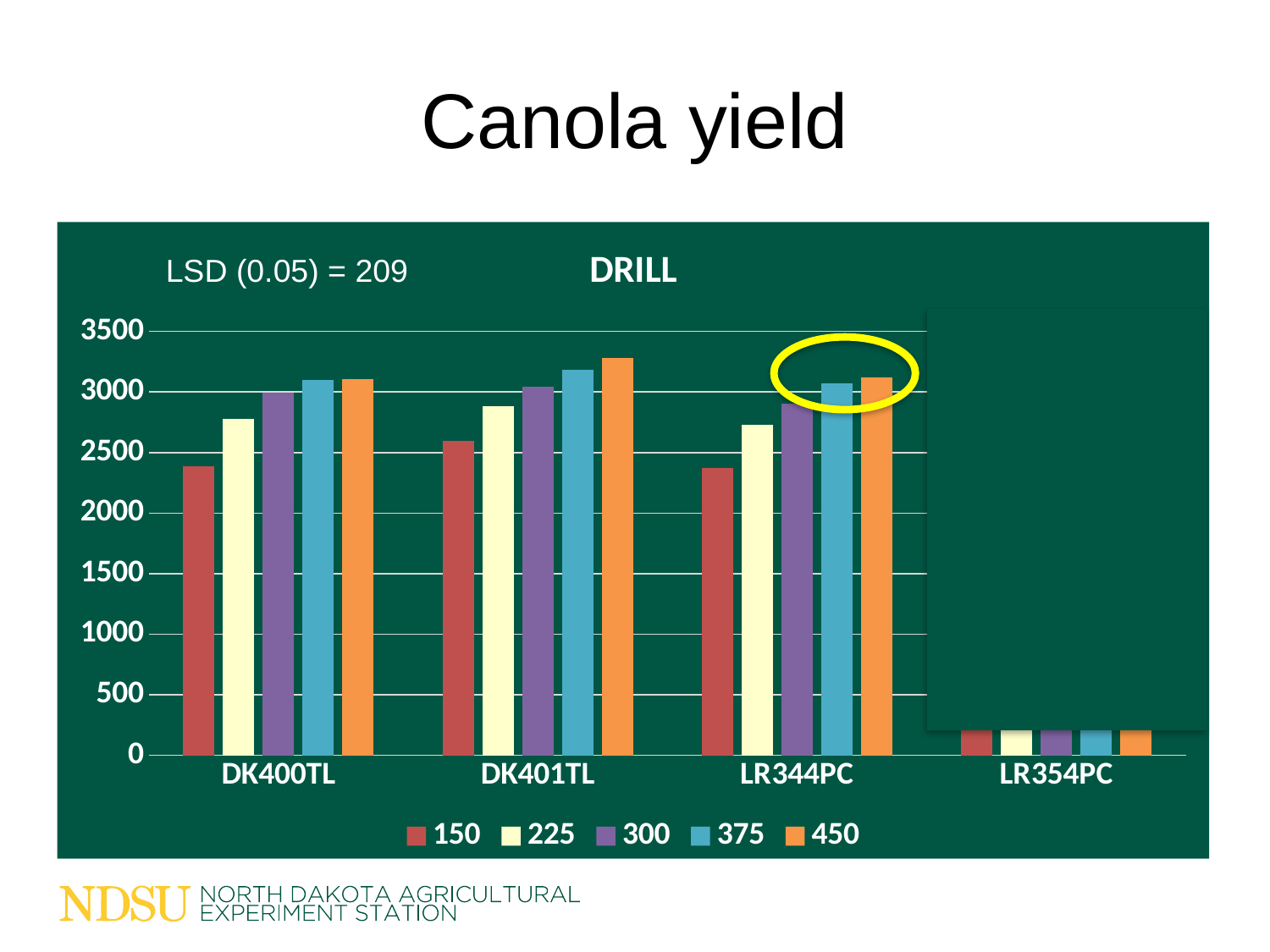
How many categories are labelled on the x axis? 4 Which series has the lowest value for DK400TL? 150 Is the value for the 450 series at DK401TL greater or less than 3000? greater Is the value for the 225 series at DK401TL greater or less than 3000? less How many series does the legend list? 5 Is the value for the 150 series at LR344PC greater or less than 2500? less What LSD (0.05) value is printed on the chart? 209 What is the title shown above the chart area? DRILL Which series has the highest value for DK401TL? 450 Do the values for DK400TL rise or fall going from the 150 series to the 450 series? rise What kind of chart is shown on the slide? bar chart